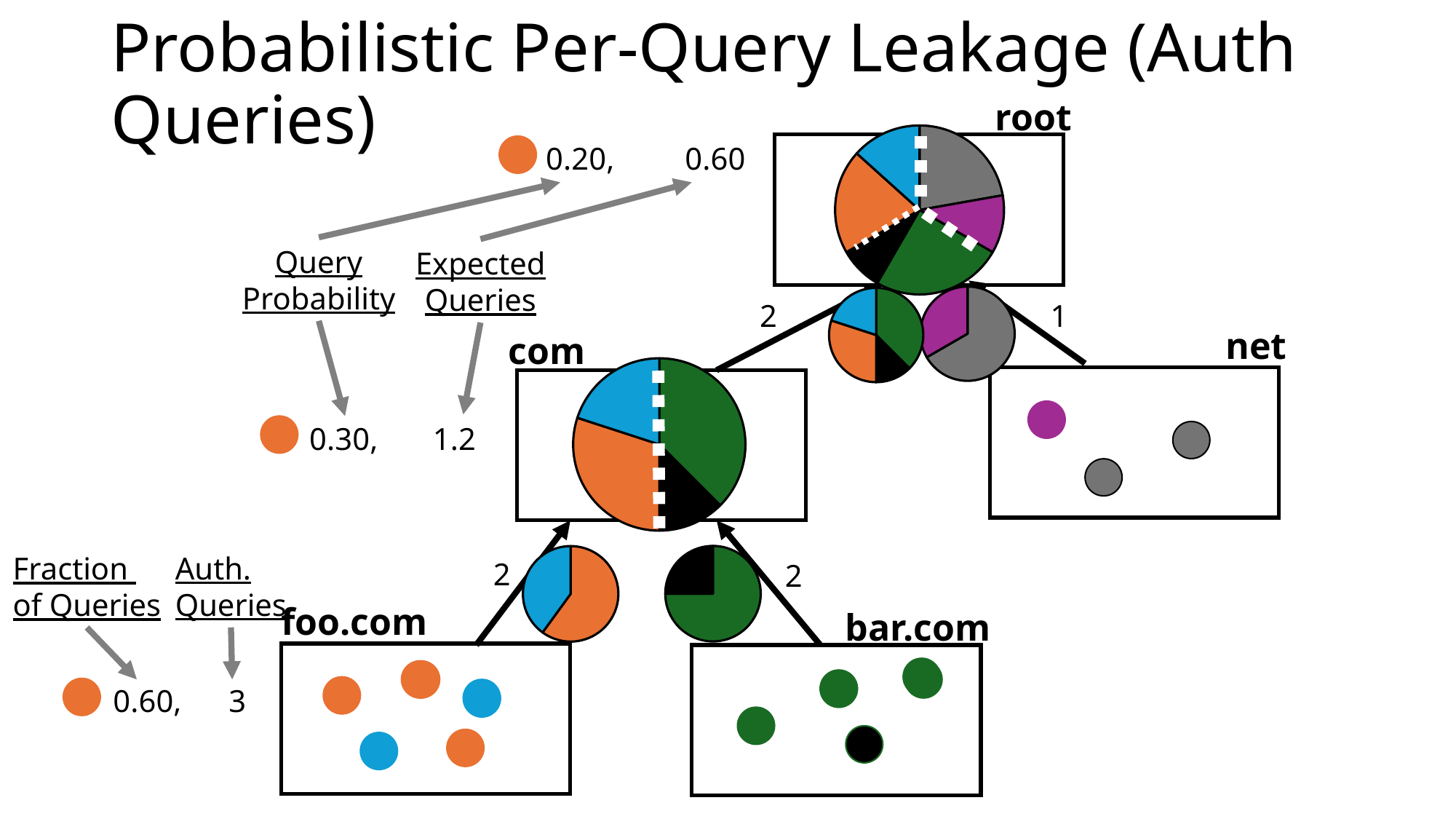
What expected-queries value is printed next to the orange dot beside the com node? 1.2 How many orange dots are inside the foo.com box? 3 What number labels the edge from net to root? 1 What query probability is printed next to the orange dot beside the com node? 0.30 What query probability is printed next to the orange dot at the top of the slide? 0.20 How many dots are drawn inside the foo.com box? 5 What kind of chart is drawn inside the com box? pie chart How many auth queries are printed next to the orange dot at the bottom left of the slide? 3 What fraction of queries is printed next to the orange dot at the bottom left of the slide? 0.60 What expected-queries value is printed next to the orange dot at the top of the slide? 0.60 How many dots are drawn inside the bar.com box? 5